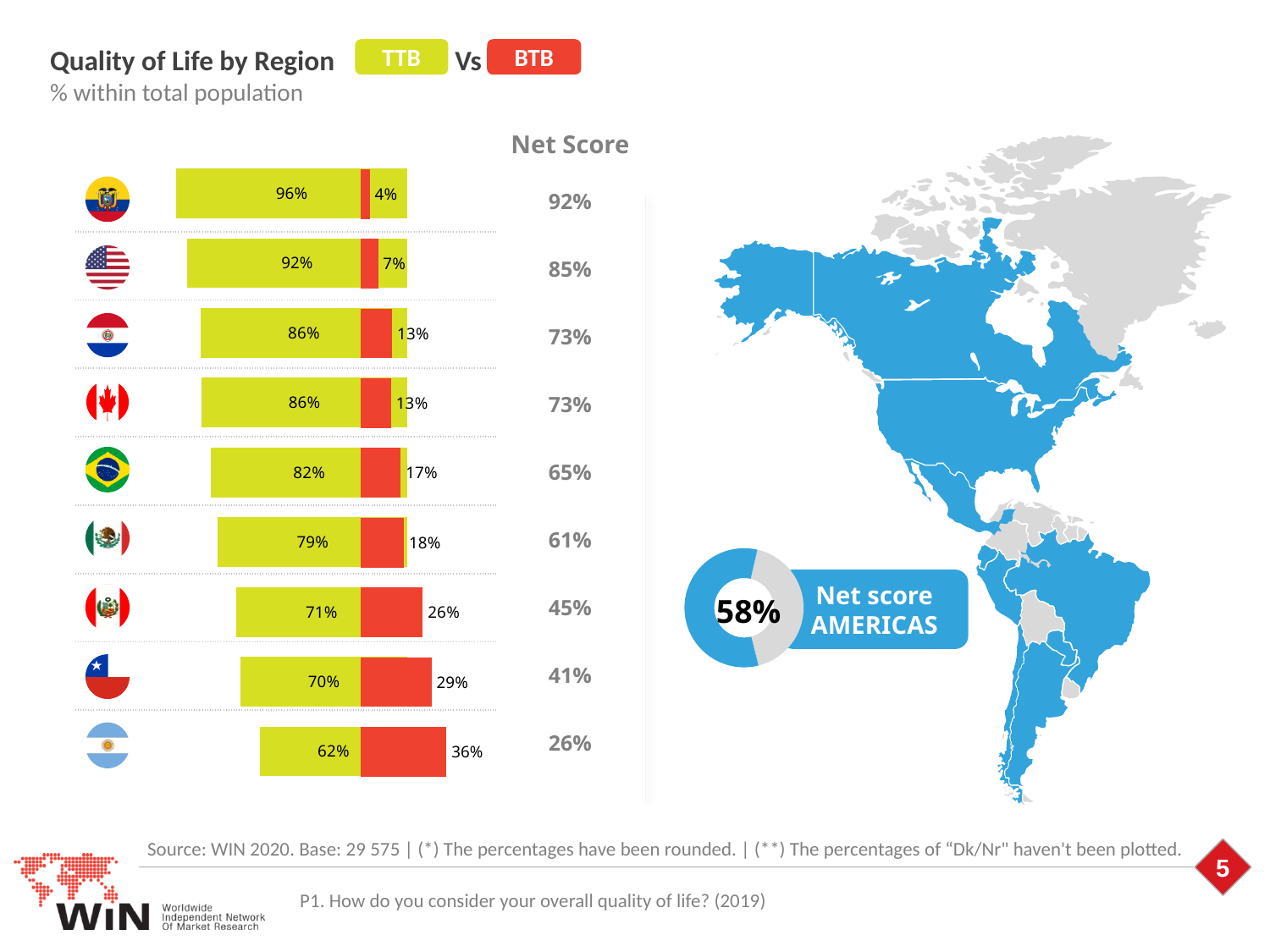
Do the TTB values in the Quality of Life by Region chart increase or decrease from the top bar to the bottom bar? Decrease In the Quality of Life by Region chart, what is the BTB value for the bottom bar? 36% How many series does the legend of the Quality of Life by Region chart list? 2 In the Quality of Life by Region chart, what is the difference between the TTB value of the top bar and the TTB value of the bottom bar? 34 percentage points In the Quality of Life by Region chart, is the TTB value of the fifth bar from the top larger or smaller than the TTB value of the sixth bar from the top? Larger How many countries (bars) are shown in the Quality of Life by Region chart? 9 In the Quality of Life by Region chart, what is the TTB value for the top bar? 96% What type of chart is used to show the TTB and BTB values on the left of the slide? Bar chart What is the lowest TTB value shown in the Quality of Life by Region chart? 62% What Net score for the Americas is shown in the donut chart on the map? 58% In the Quality of Life by Region chart, what is the Net Score shown for the bottom bar? 26% What is the highest Net Score shown in the Quality of Life by Region chart? 92%